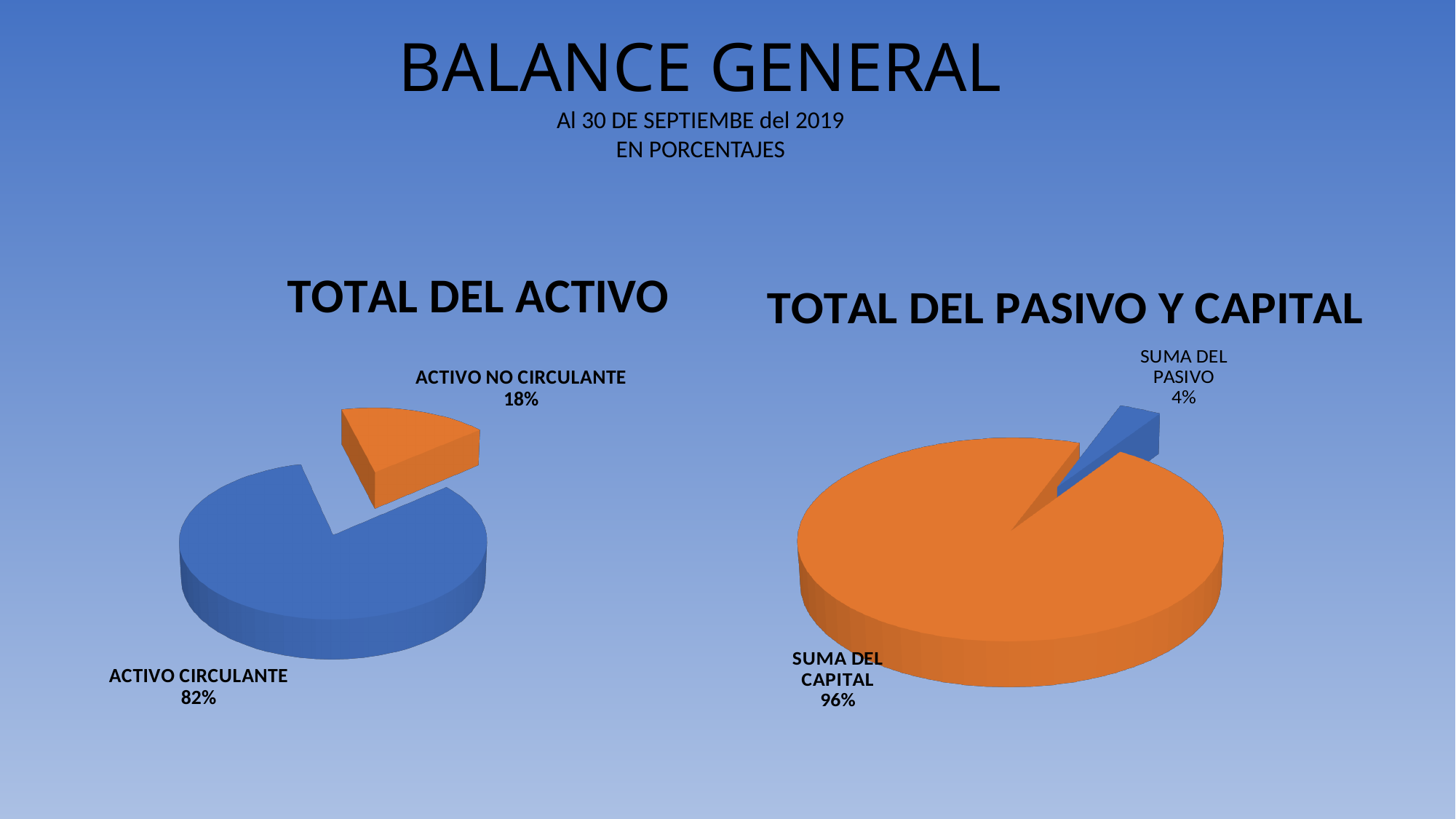
In the 'TOTAL DEL ACTIVO' chart, what is the difference between ACTIVO CIRCULANTE and ACTIVO NO CIRCULANTE? 64% In the 'TOTAL DEL PASIVO Y CAPITAL' chart, what is the value for SUMA DEL PASIVO? 4% In the 'TOTAL DEL PASIVO Y CAPITAL' chart, which slice is the smallest? SUMA DEL PASIVO Which is larger: ACTIVO NO CIRCULANTE in the left chart or SUMA DEL PASIVO in the right chart? ACTIVO NO CIRCULANTE In the 'TOTAL DEL PASIVO Y CAPITAL' chart, what share does SUMA DEL CAPITAL have? 96% In the 'TOTAL DEL ACTIVO' chart, what share does ACTIVO CIRCULANTE have? 82% How many slices does the 'TOTAL DEL ACTIVO' chart have? 2 What is the title of the chart on the right side of the slide? TOTAL DEL PASIVO Y CAPITAL What kind of chart is 'TOTAL DEL PASIVO Y CAPITAL'? Pie chart In the 'TOTAL DEL PASIVO Y CAPITAL' chart, what is the difference between SUMA DEL CAPITAL and SUMA DEL PASIVO? 92% In the 'TOTAL DEL ACTIVO' chart, which slice is the largest? ACTIVO CIRCULANTE In the 'TOTAL DEL ACTIVO' chart, what is the value for ACTIVO NO CIRCULANTE? 18%